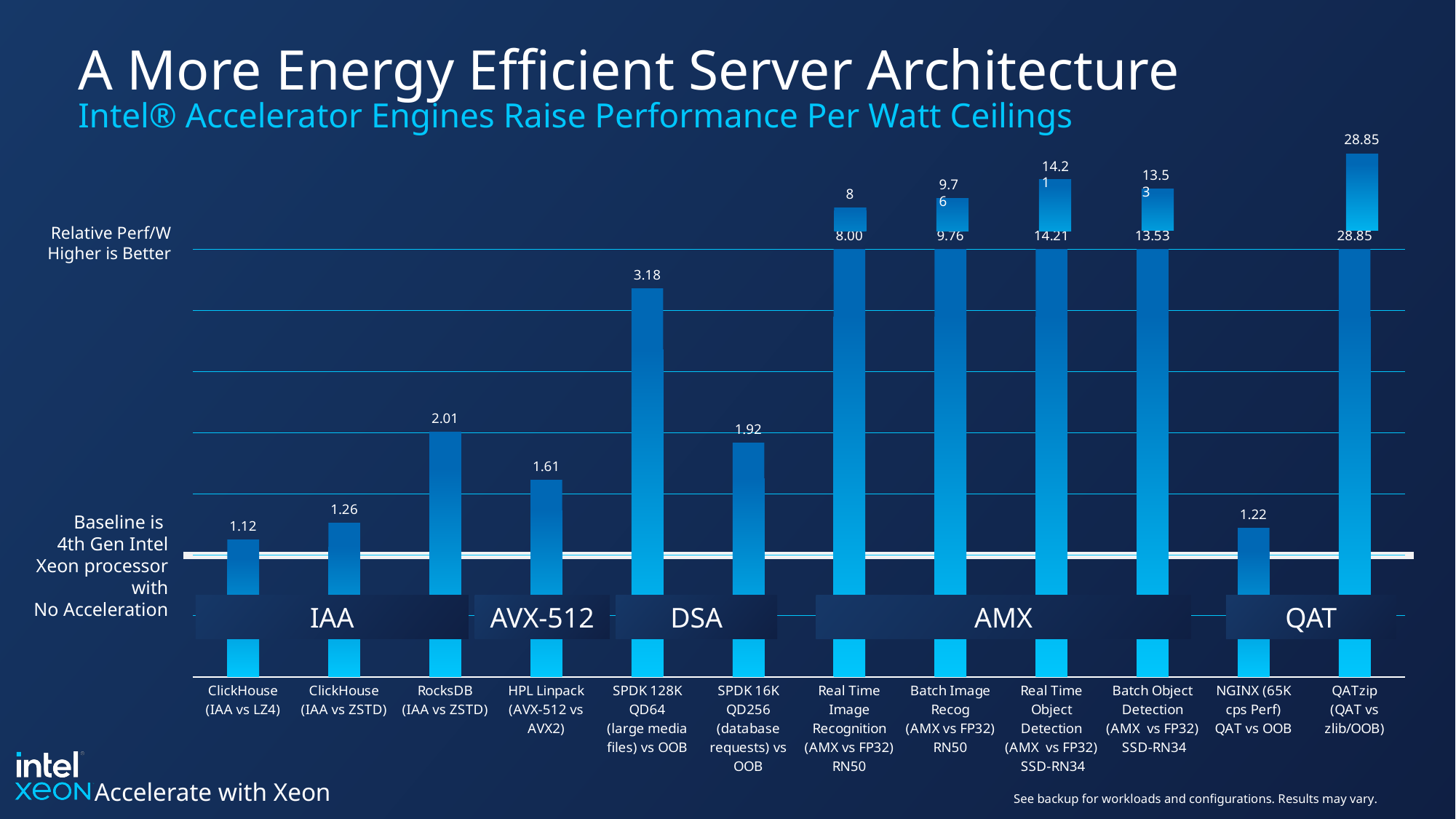
What kind of chart is shown on the slide? Bar chart What is the difference between the relative Perf/W values for RocksDB (IAA vs ZSTD) and ClickHouse (IAA vs ZSTD)? 0.75 Which workload has the lowest relative Perf/W value? ClickHouse (IAA vs LZ4) What is the relative Perf/W value for ClickHouse (IAA vs LZ4)? 1.12 What is the relative Perf/W value for NGINX (65K cps Perf) QAT vs OOB? 1.22 How many workloads are plotted in the chart? 12 What is the relative Perf/W value for SPDK 128K QD64 (large media files) vs OOB? 3.18 Which accelerator engine group contains the most workloads in the chart? AMX What is the difference between the relative Perf/W values for Real Time Object Detection (AMX vs FP32) SSD-RN34 and Batch Object Detection (AMX vs FP32) SSD-RN34? 0.68 What is the relative Perf/W value for Real Time Object Detection (AMX vs FP32) SSD-RN34? 14.21 Which has a larger relative Perf/W value: SPDK 16K QD256 (database requests) vs OOB or HPL Linpack (AVX-512 vs AVX2)? SPDK 16K QD256 (database requests) vs OOB Which workload has the highest relative Perf/W value? QATzip (QAT vs zlib/OOB)